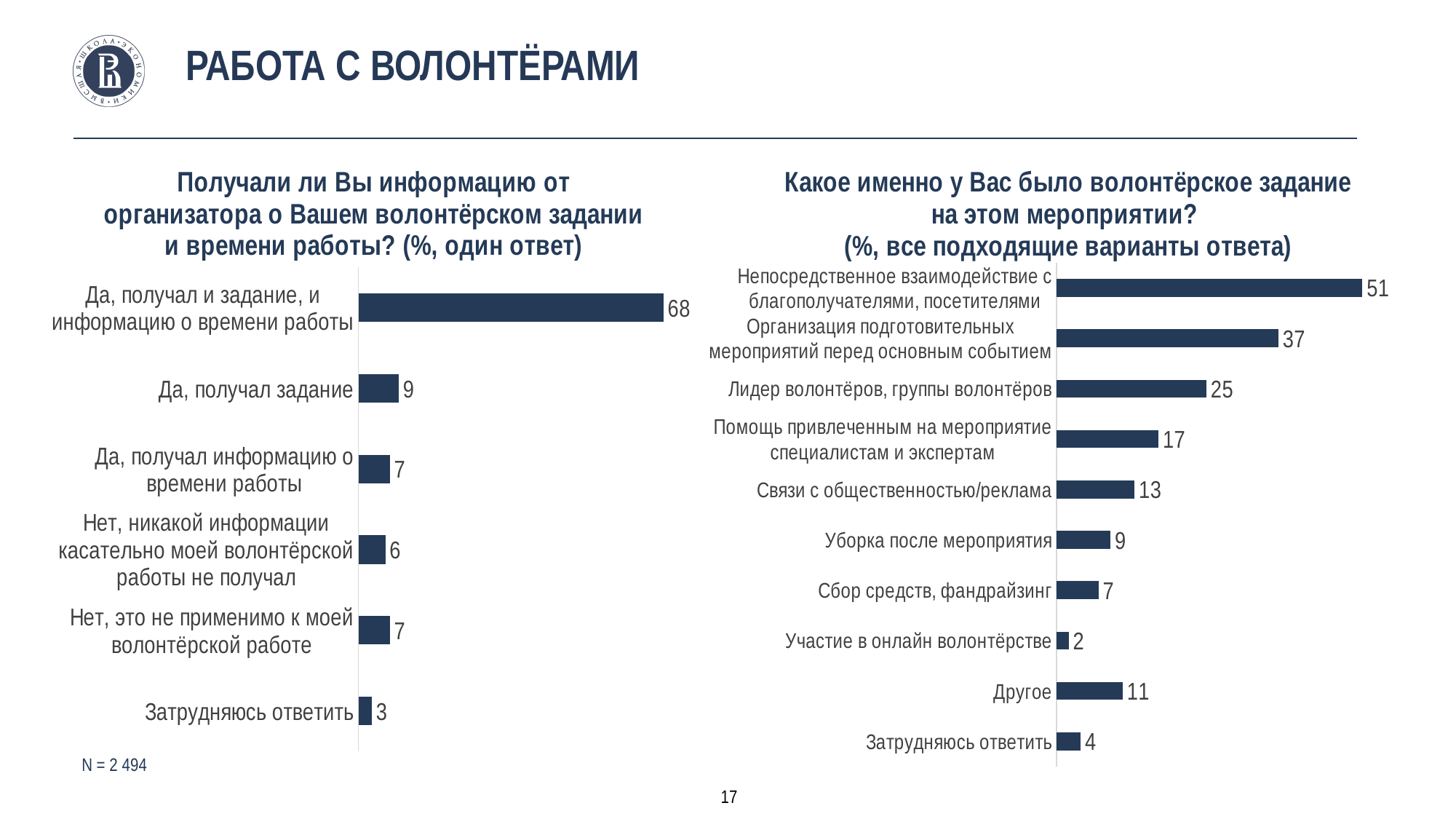
In the right chart (Какое именно у Вас было волонтёрское задание...), what is the value for 'Лидер волонтёров, группы волонтёров'? 25 In the right chart (Какое именно у Вас было волонтёрское задание...), which category has the lowest value? Участие в онлайн волонтёрстве In the left chart (Получали ли Вы информацию от организатора...), what kind of chart is it? Bar chart In the right chart (Какое именно у Вас было волонтёрское задание...), which category has the highest value? Непосредственное взаимодействие с благополучателями, посетителями In the left chart (Получали ли Вы информацию от организатора...), what is the difference between 'Да, получал задание' and 'Нет, никакой информации касательно моей волонтёрской работы не получал'? 3 In the right chart (Какое именно у Вас было волонтёрское задание...), how many categories are shown? 10 What sample size (N) is stated on the slide? N = 2 494 In the right chart (Какое именно у Вас было волонтёрское задание...), which is larger: 'Связи с общественностью/реклама' or 'Другое'? Связи с общественностью/реклама In the left chart (Получали ли Вы информацию от организатора...), which category has the lowest value? Затрудняюсь ответить In the left chart (Получали ли Вы информацию от организатора...), how many categories are shown? 6 In the left chart (Получали ли Вы информацию от организатора...), what is the value for 'Да, получал и задание, и информацию о времени работы'? 68 In the right chart (Какое именно у Вас было волонтёрское задание...), what is the difference between 'Непосредственное взаимодействие с благополучателями, посетителями' and 'Организация подготовительных мероприятий перед основным событием'? 14